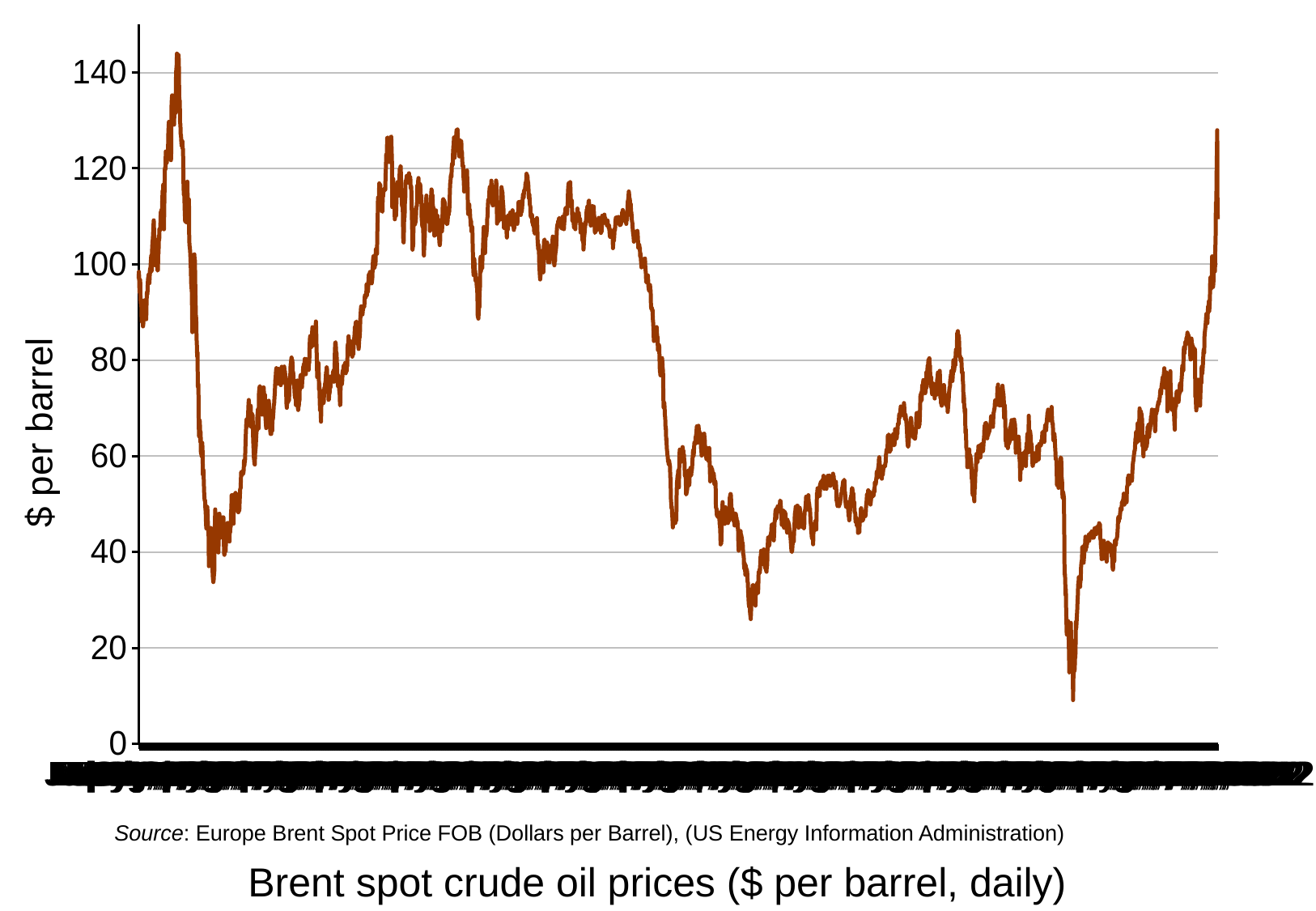
Is the highest value reached by the line greater or less than 140? greater What is the highest tick value shown on the vertical axis? 140 Is the lowest value reached by the line greater or less than 40? less Is the value at the right-hand end of the line greater or less than 120? greater What kind of chart is shown on the slide? line chart How many data series are plotted on the chart? 1 What is the title of the chart? Brent spot crude oil prices ($ per barrel, daily) What is the label on the vertical axis of the chart? $ per barrel